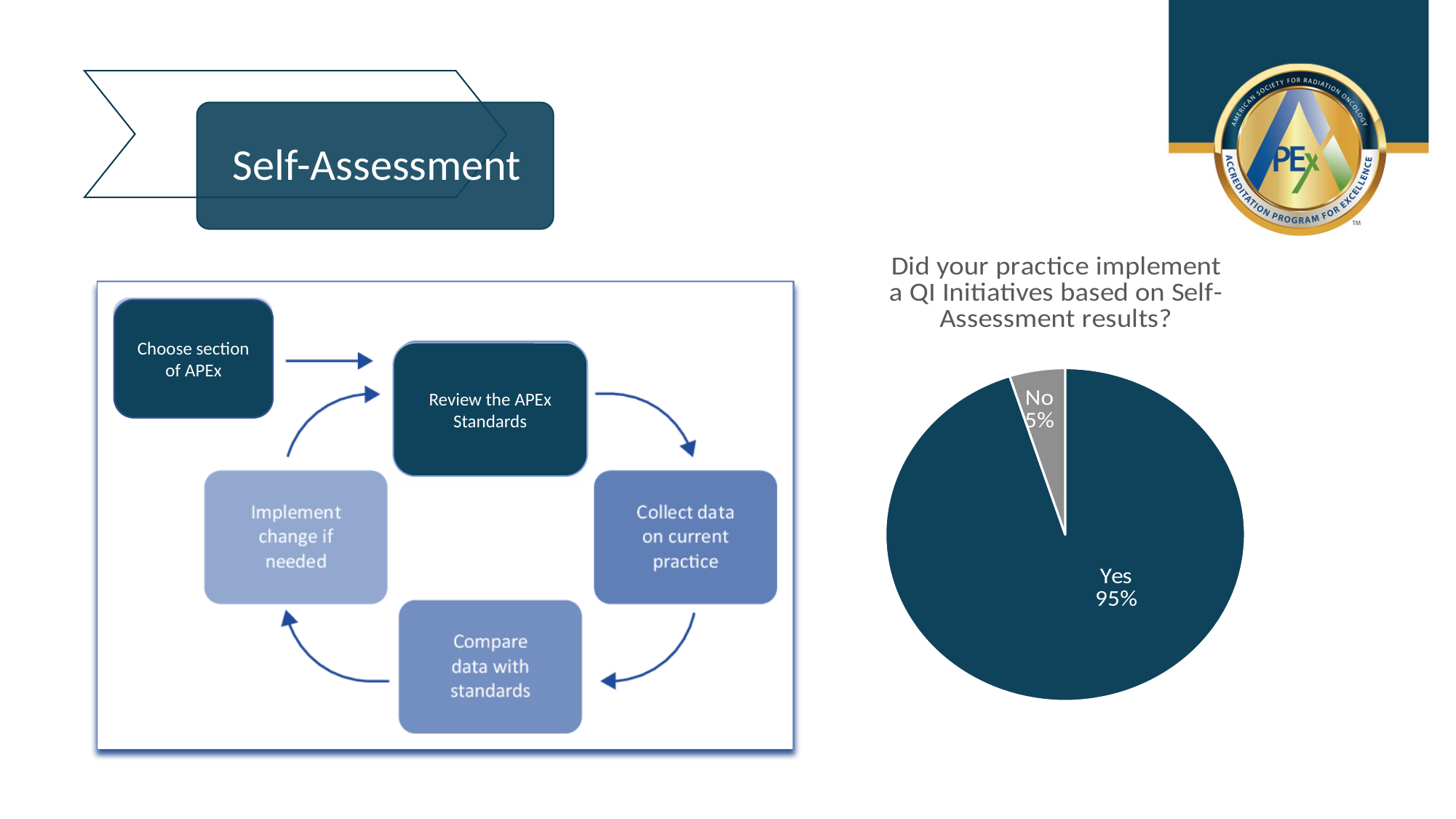
What colour is the "No" slice of the pie chart? grey What percentage of the pie chart is labelled "Yes"? 95% Which is larger in the pie chart, the "Yes" slice or the "No" slice? Yes How many slices does the pie chart have? 2 What is the title of the pie chart? Did your practice implement a QI Initiatives based on Self-Assessment results? What percentage of the pie chart is labelled "No"? 5% What kind of chart is shown on the slide? pie chart Which slice of the pie chart is the smallest? No What share of the pie does the "Yes" slice represent? 95% Which slice of the pie chart is the largest? Yes What is the difference in percentage points between the "Yes" and "No" slices? 90